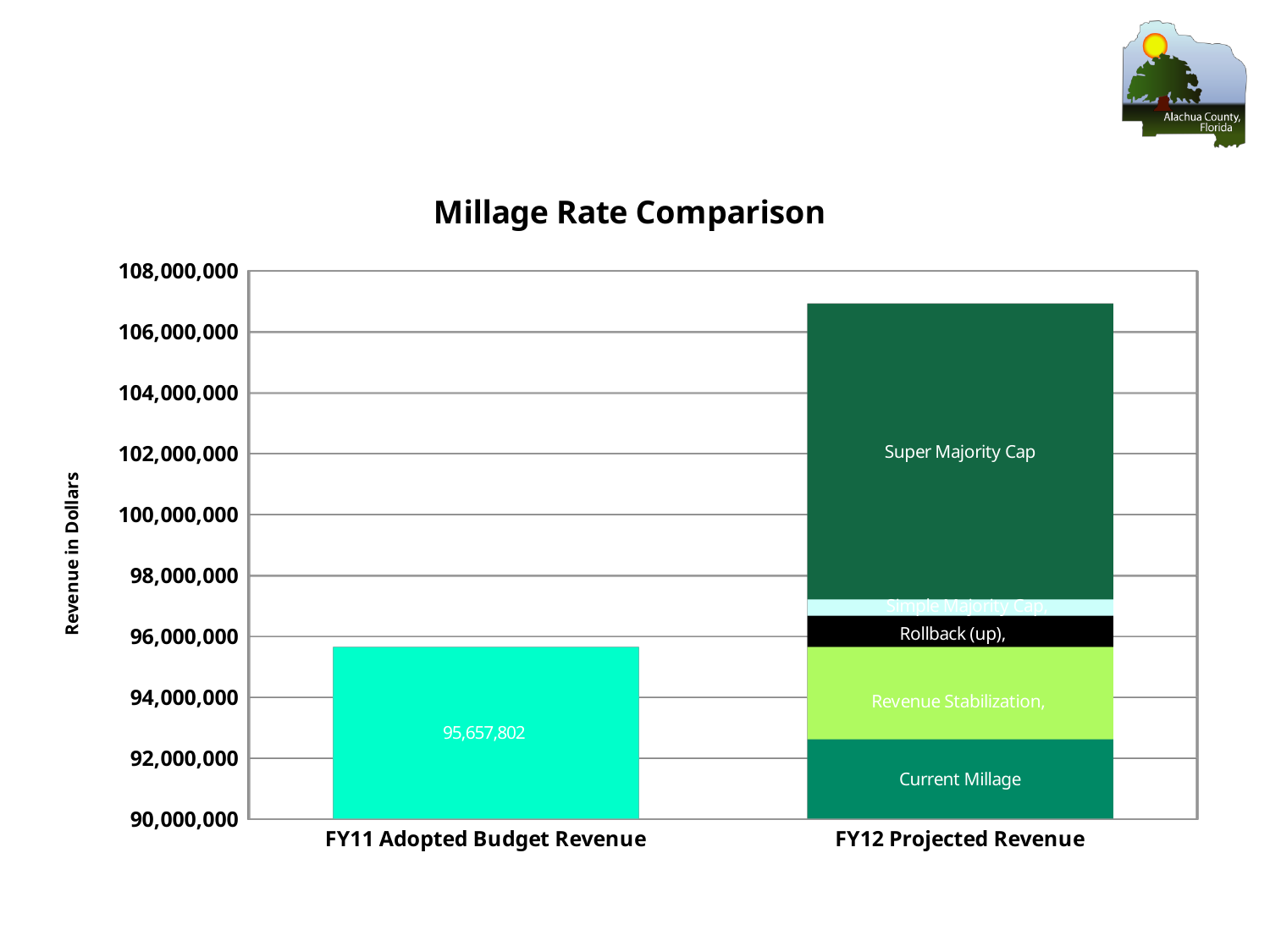
What is the value shown for FY11 Adopted Budget Revenue? 95,657,802 What kind of chart is shown on the slide? bar chart How many segments make up the FY12 Projected Revenue bar? 5 Which segment is at the top of the FY12 Projected Revenue bar? Super Majority Cap How many categories are shown on the x axis? 2 Is the total of the FY12 Projected Revenue bar greater or less than 106,000,000? greater Is the top of the Current Millage segment in the FY12 Projected Revenue bar greater or less than 94,000,000? less Which category has the taller bar, FY11 Adopted Budget Revenue or FY12 Projected Revenue? FY12 Projected Revenue Is the value for FY11 Adopted Budget Revenue greater or less than 96,000,000? less Do the values rise or fall from FY11 Adopted Budget Revenue to FY12 Projected Revenue? rise What is the title of the chart? Millage Rate Comparison Which category has the highest total value? FY12 Projected Revenue